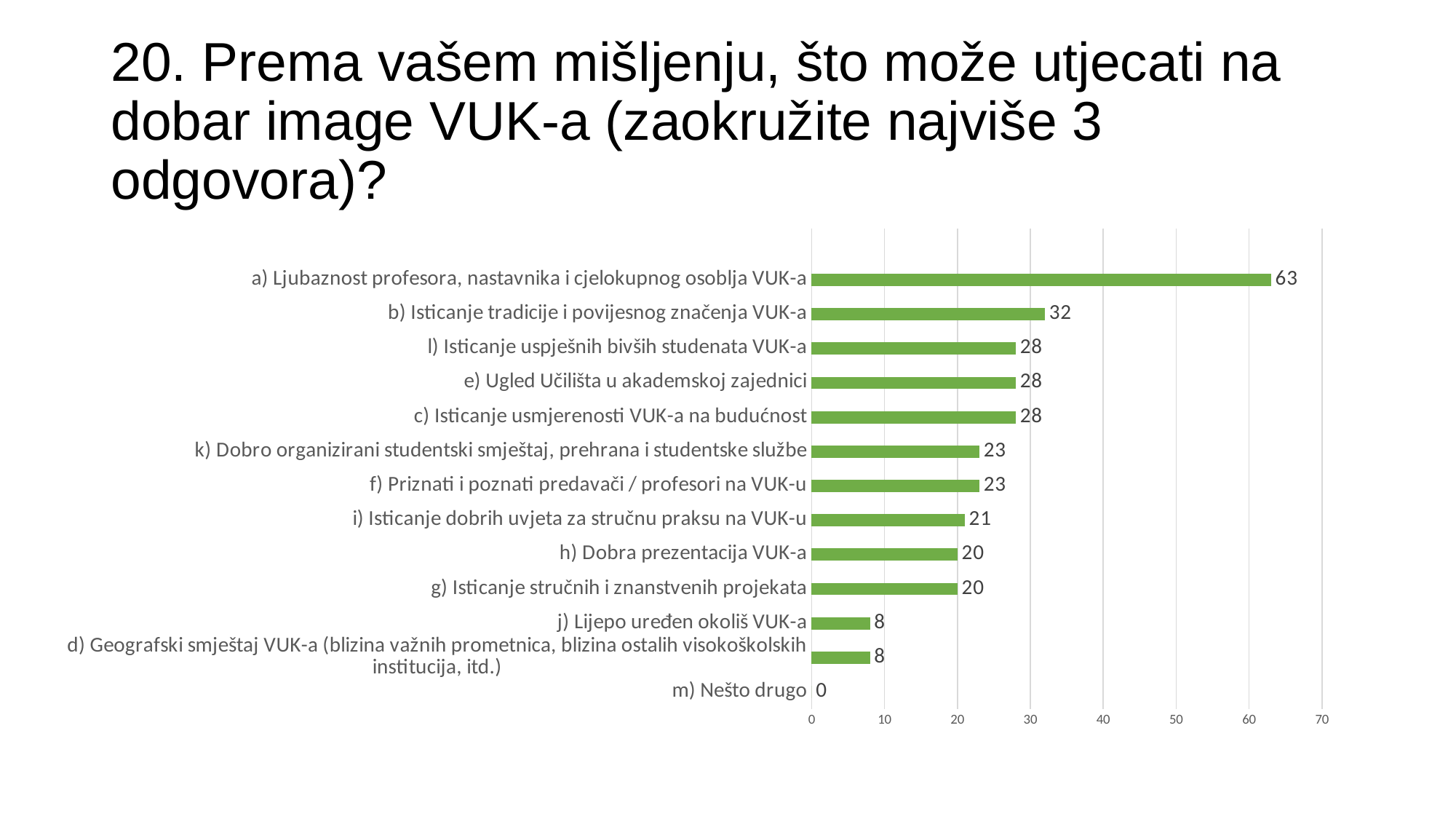
What is the value for "m) Nešto drugo"? 0 What is the value for "a) Ljubaznost profesora, nastavnika i cjelokupnog osoblja VUK-a"? 63 What kind of chart is shown on the slide? bar chart What is the value for "h) Dobra prezentacija VUK-a"? 20 Which has a larger value: "i) Isticanje dobrih uvjeta za stručnu praksu na VUK-u" or "j) Lijepo uređen okoliš VUK-a"? i) Isticanje dobrih uvjeta za stručnu praksu na VUK-u Which category has the lowest value? m) Nešto drugo What is the difference between the values for "a) Ljubaznost profesora, nastavnika i cjelokupnog osoblja VUK-a" and "b) Isticanje tradicije i povijesnog značenja VUK-a"? 31 Is the value for "k) Dobro organizirani studentski smještaj, prehrana i studentske službe" greater or less than 30? less What colour are the bars in the chart? green How many categories are shown in the chart? 13 What is the value for "b) Isticanje tradicije i povijesnog značenja VUK-a"? 32 Which category has the highest value? a) Ljubaznost profesora, nastavnika i cjelokupnog osoblja VUK-a